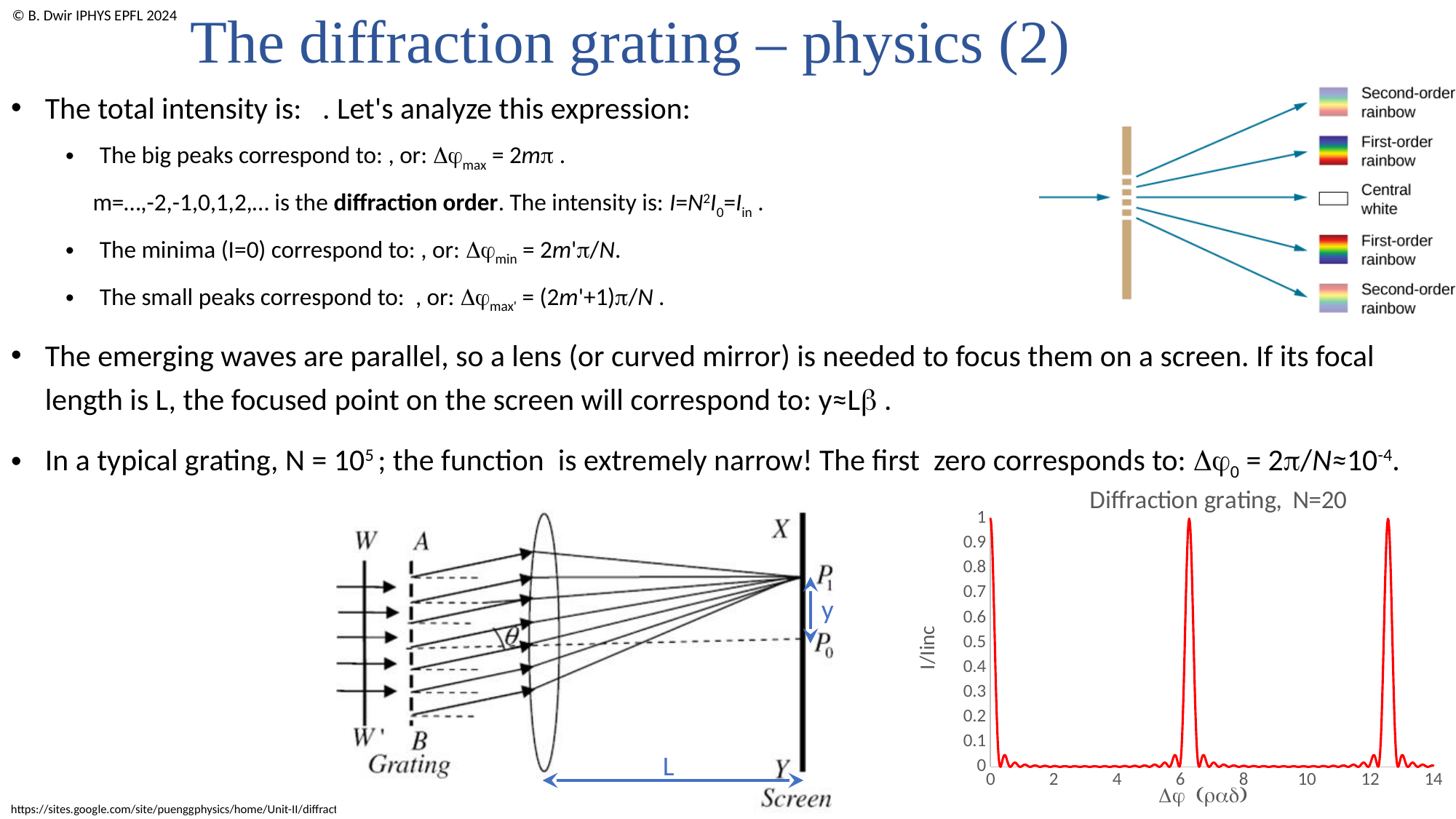
In the "Diffraction grating, N=20" chart, is the value at Δφ = 10 greater or less than 0.2? less In the "Diffraction grating, N=20" chart, is the value at Δφ = 4 greater or less than 0.1? less In the "Diffraction grating, N=20" chart, what is the highest value reached by the curve? 1 In the "Diffraction grating, N=20" chart, is the value at Δφ = 0 greater or less than 0.9? greater In the "Diffraction grating, N=20" chart, does the curve rise steadily, fall steadily, or oscillate with repeated peaks along the x axis? oscillate with repeated peaks In the "Diffraction grating, N=20" chart, what is the largest tick value shown on the x axis? 14 What is the title of the chart at the bottom right of the slide? Diffraction grating, N=20 In the "Diffraction grating, N=20" chart, what is the label of the y axis? I/Iinc What colour is the line plotted in the "Diffraction grating, N=20" chart? red In the "Diffraction grating, N=20" chart, how many large peaks reach the top of the y axis? 3 What kind of chart is the "Diffraction grating, N=20" chart? line chart In the "Diffraction grating, N=20" chart, is the value at Δφ = 2 larger or smaller than the value at Δφ = 0? smaller